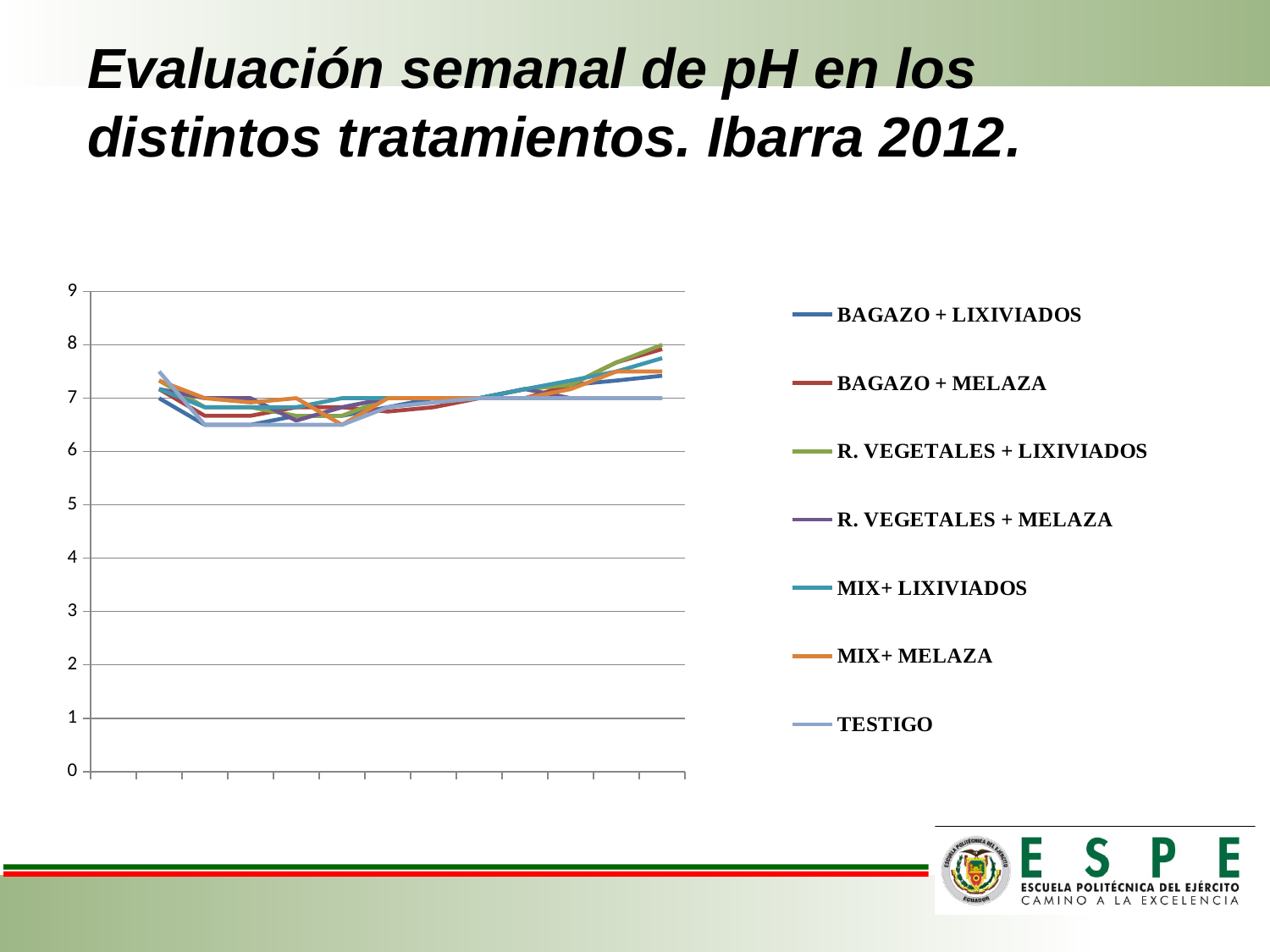
Is the value for TESTIGO at the right end of the chart greater or less than 8? less Is the value for BAGAZO + LIXIVIADOS at the right end of the chart greater or less than 8? less What is the highest value shown on the y axis? 9 How many series does the legend list? 7 Is the value for TESTIGO at the left end of the chart greater or less than 7? greater Which series is listed last in the legend? TESTIGO What kind of chart is shown on the slide? Line chart Do the values for R. VEGETALES + LIXIVIADOS rise or fall over the right-hand half of the chart? rise What is the title of the slide containing the chart? Evaluación semanal de pH en los distintos tratamientos. Ibarra 2012. At the right end of the chart, which is larger: the value for R. VEGETALES + LIXIVIADOS or the value for TESTIGO? R. VEGETALES + LIXIVIADOS